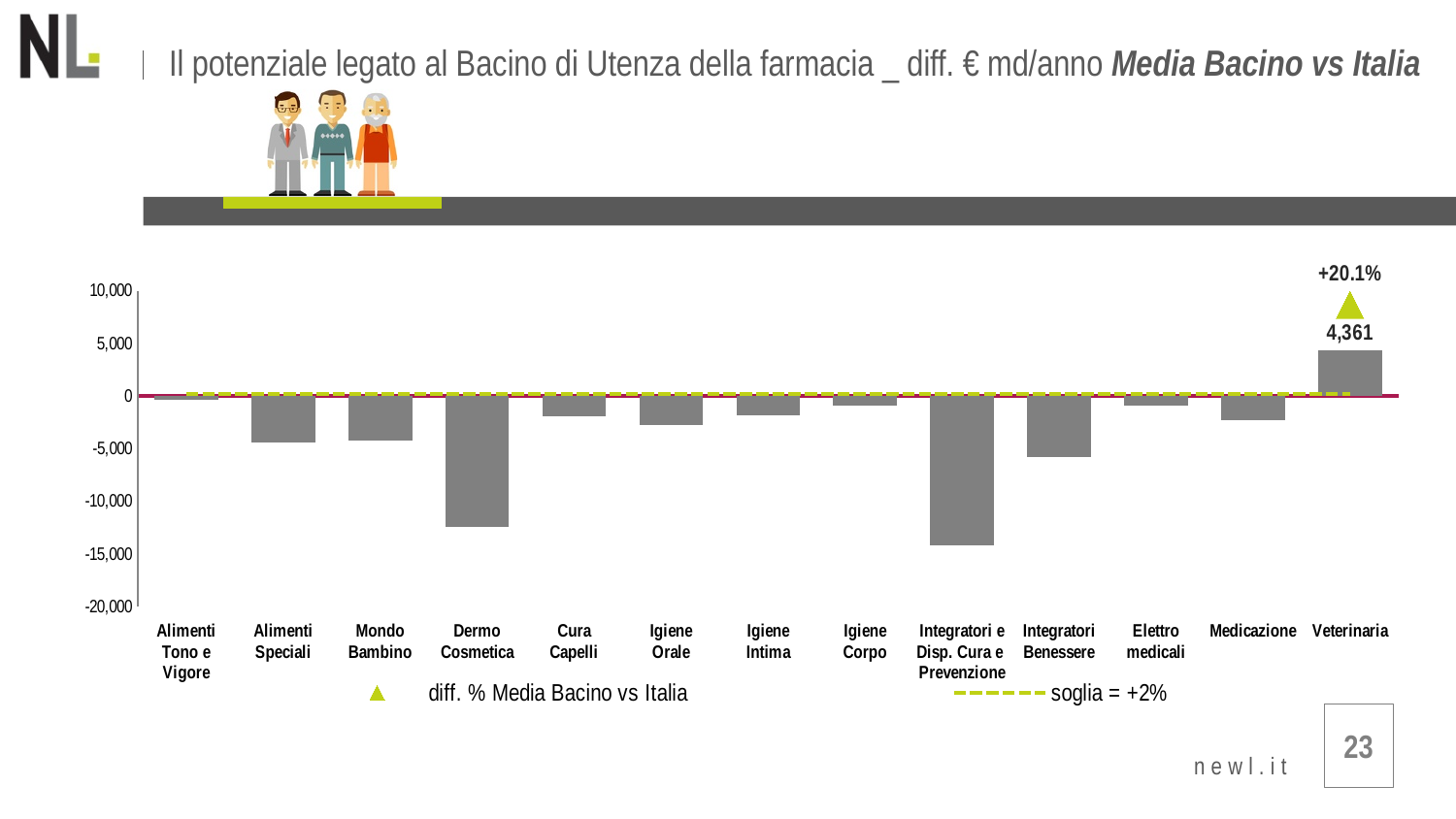
How many categories are shown on the x axis of the chart? 13 What percentage difference is printed above the Veterinaria bar? +20.1% Is the value for Alimenti Speciali greater or less than -5,000? greater Is the value for Integratori Benessere greater or less than -5,000? less How many entries does the legend list? 2 Which bar extends further below zero, Dermo Cosmetica or Mondo Bambino? Dermo Cosmetica Is the value for Dermo Cosmetica greater or less than -10,000? less What is the value printed for Veterinaria? 4,361 What type of chart is shown on the slide? bar chart What threshold value is stated in the legend for the dashed line? soglia = +2% Which category has the lowest value in the chart? Integratori e Disp. Cura e Prevenzione Which category has the highest value in the chart? Veterinaria